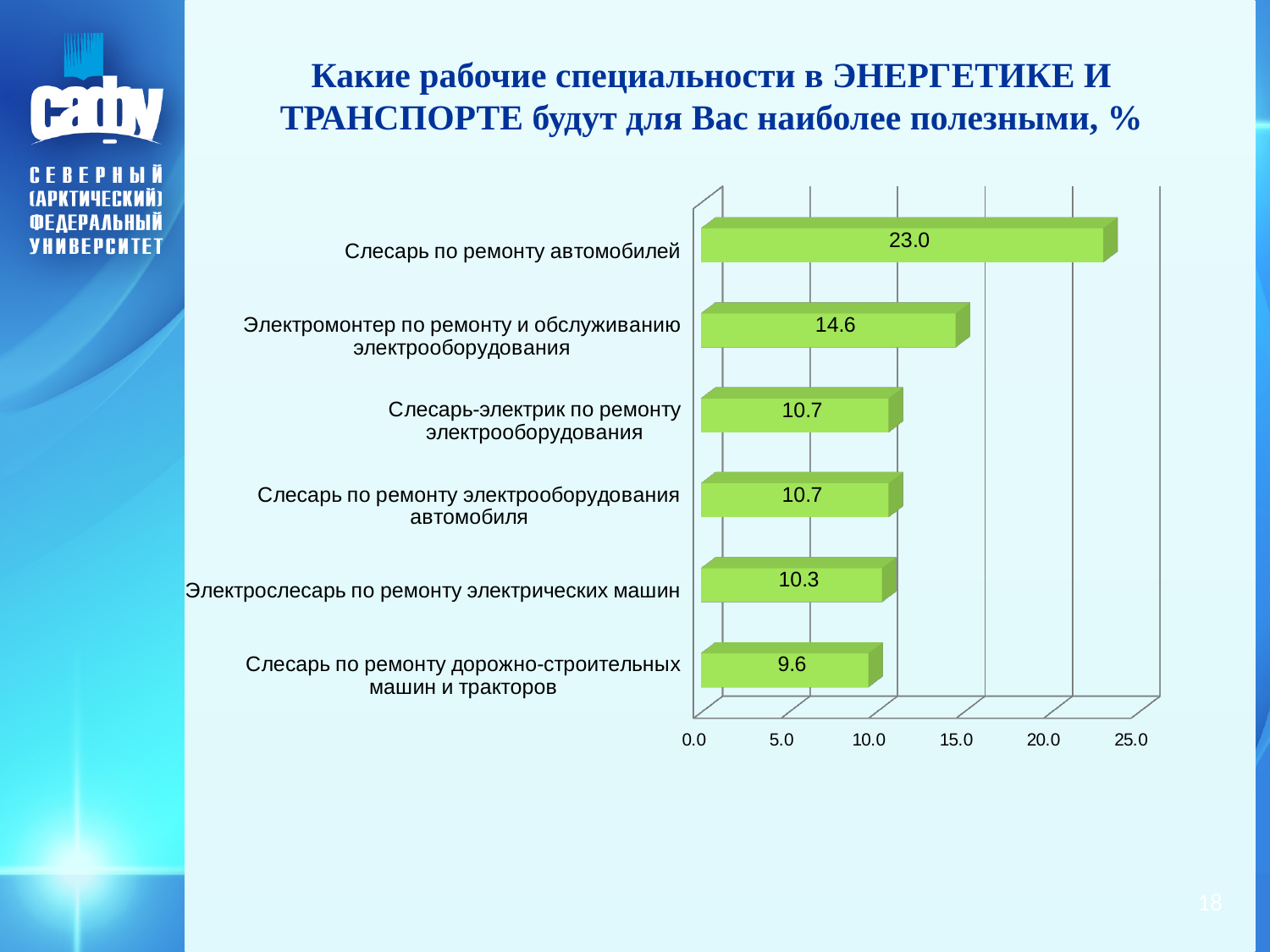
What is the value for Слесарь по ремонту автомобилей? 23.0 What is the difference between the values for Слесарь по ремонту автомобилей and Электромонтер по ремонту и обслуживанию электрооборудования? 8.4 What is the value for Электромонтер по ремонту и обслуживанию электрооборудования? 14.6 Is the value for Слесарь по ремонту автомобилей greater or less than 20.0? greater What is the value for Электрослесарь по ремонту электрических машин? 10.3 How many categories are shown in the chart? 6 What is the value for Слесарь по ремонту электрооборудования автомобиля? 10.7 Which is larger: the value for Электромонтер по ремонту и обслуживанию электрооборудования or the value for Слесарь-электрик по ремонту электрооборудования? Электромонтер по ремонту и обслуживанию электрооборудования What kind of chart is shown on the slide? bar chart What is the value for Слесарь по ремонту дорожно-строительных машин и тракторов? 9.6 Which category has the lowest value? Слесарь по ремонту дорожно-строительных машин и тракторов Which category has the highest value? Слесарь по ремонту автомобилей